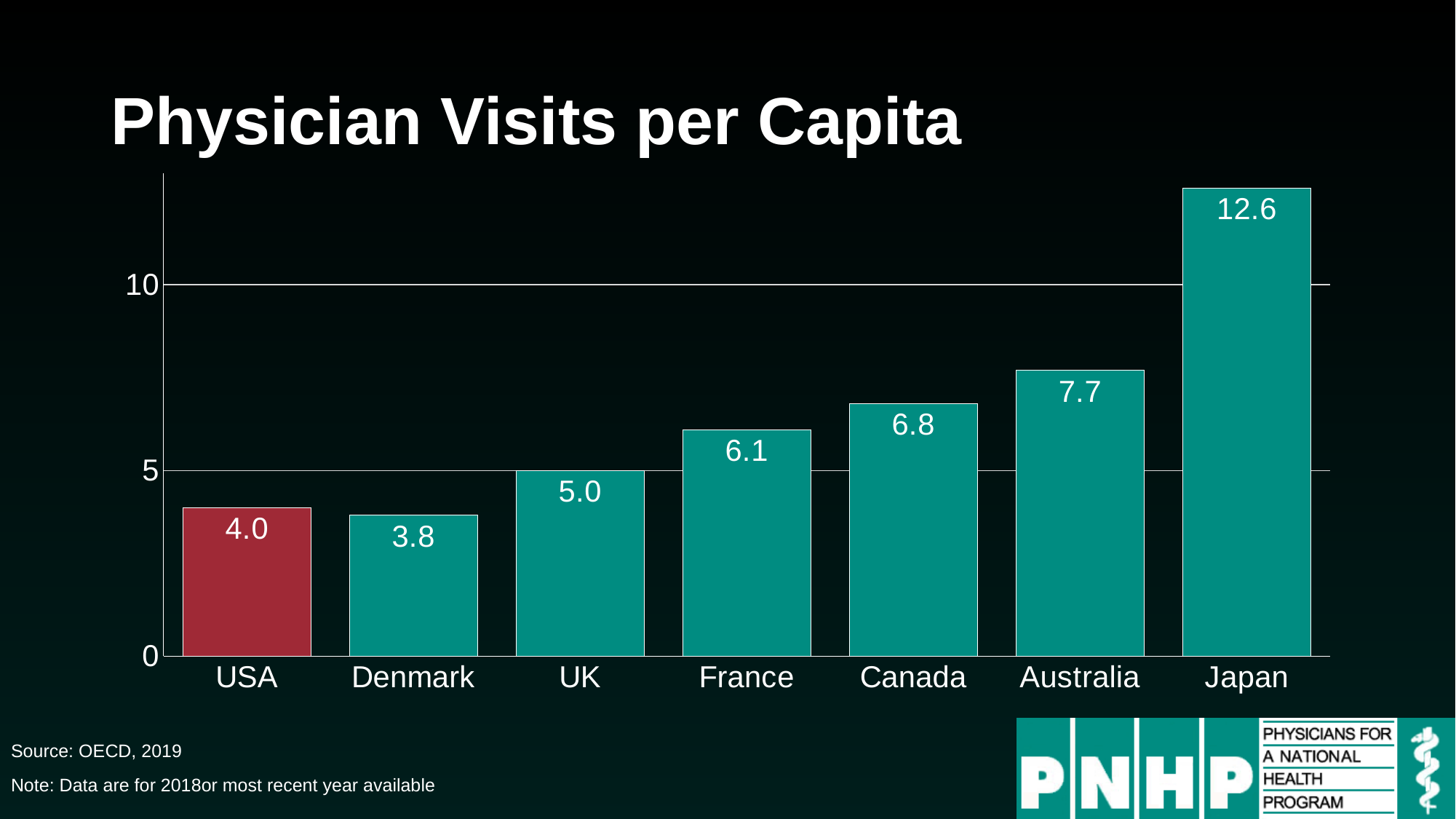
What is the difference between the values for Australia and France? 1.6 What is the value for Canada? 6.8 Is the value for Australia greater or less than 10? less Which is larger, the value for France or the value for the UK? France Which country has the lowest number of physician visits per capita? Denmark How many countries are shown in the chart? 7 Which country has the highest number of physician visits per capita? Japan What is the value for Japan? 12.6 What is the value for the USA? 4.0 What is the difference between the values for Japan and the USA? 8.6 What kind of chart is shown on the slide? bar chart Which bar is coloured differently from the others? USA